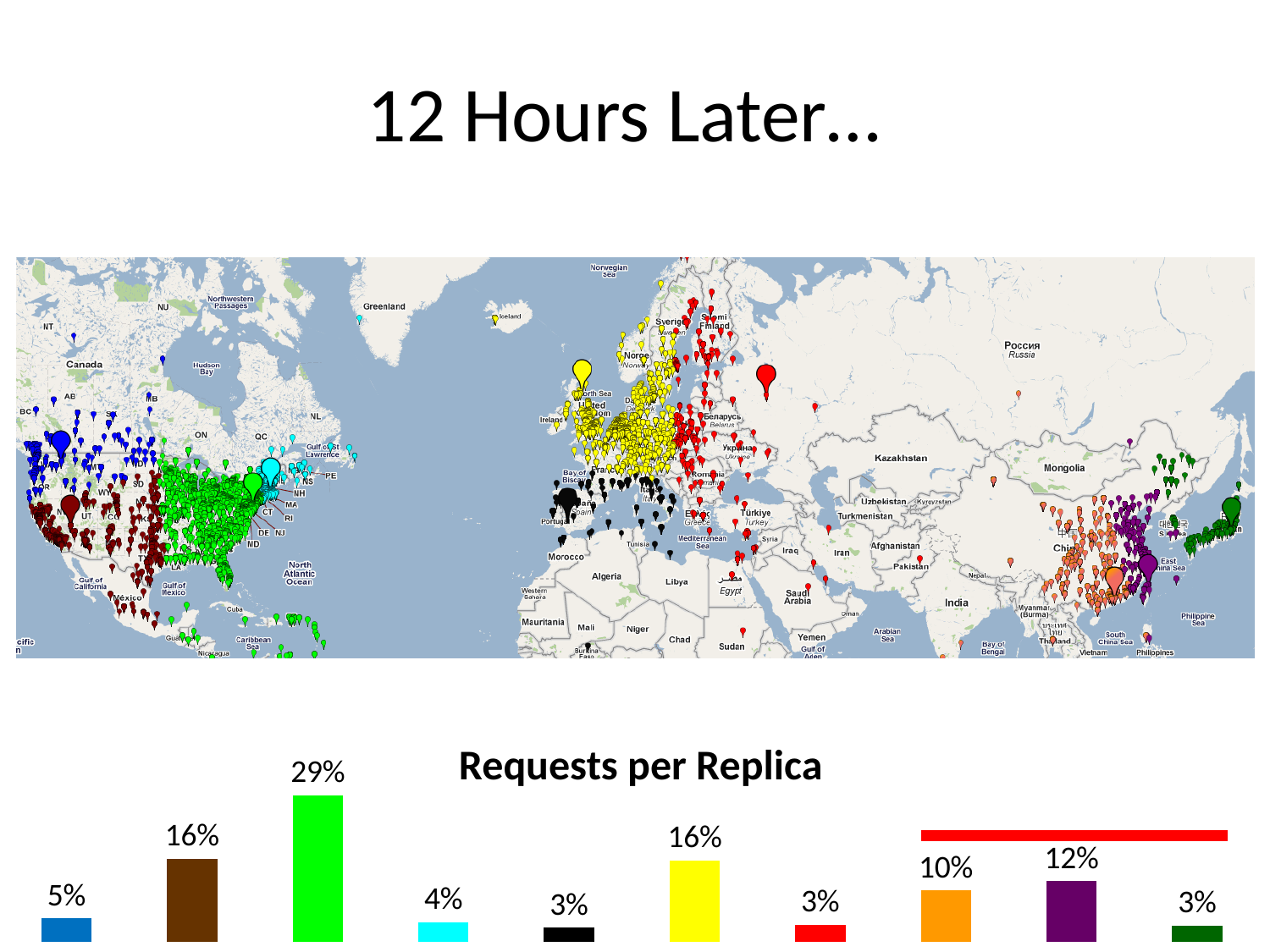
What is the title of the bar chart at the bottom of the slide? Requests per Replica In the Requests per Replica chart, which is larger: the blue bar or the cyan bar? the blue bar (5%) In the Requests per Replica chart, what value is labelled on the bright green bar? 29% In the Requests per Replica chart, which coloured bar has the highest value? the bright green bar (29%) In the Requests per Replica chart, how many bars are plotted? 10 In the Requests per Replica chart, what value is labelled on the yellow bar? 16% In the Requests per Replica chart, what value is labelled on the purple bar? 12% In the Requests per Replica chart, what is the difference between the purple bar and the orange bar? 2% In the Requests per Replica chart, what is the difference between the bright green bar and the brown bar? 13% In the Requests per Replica chart, what value is labelled on the orange bar? 10% What kind of chart is shown under the title "Requests per Replica"? bar chart In the Requests per Replica chart, what value is labelled on the brown bar? 16%